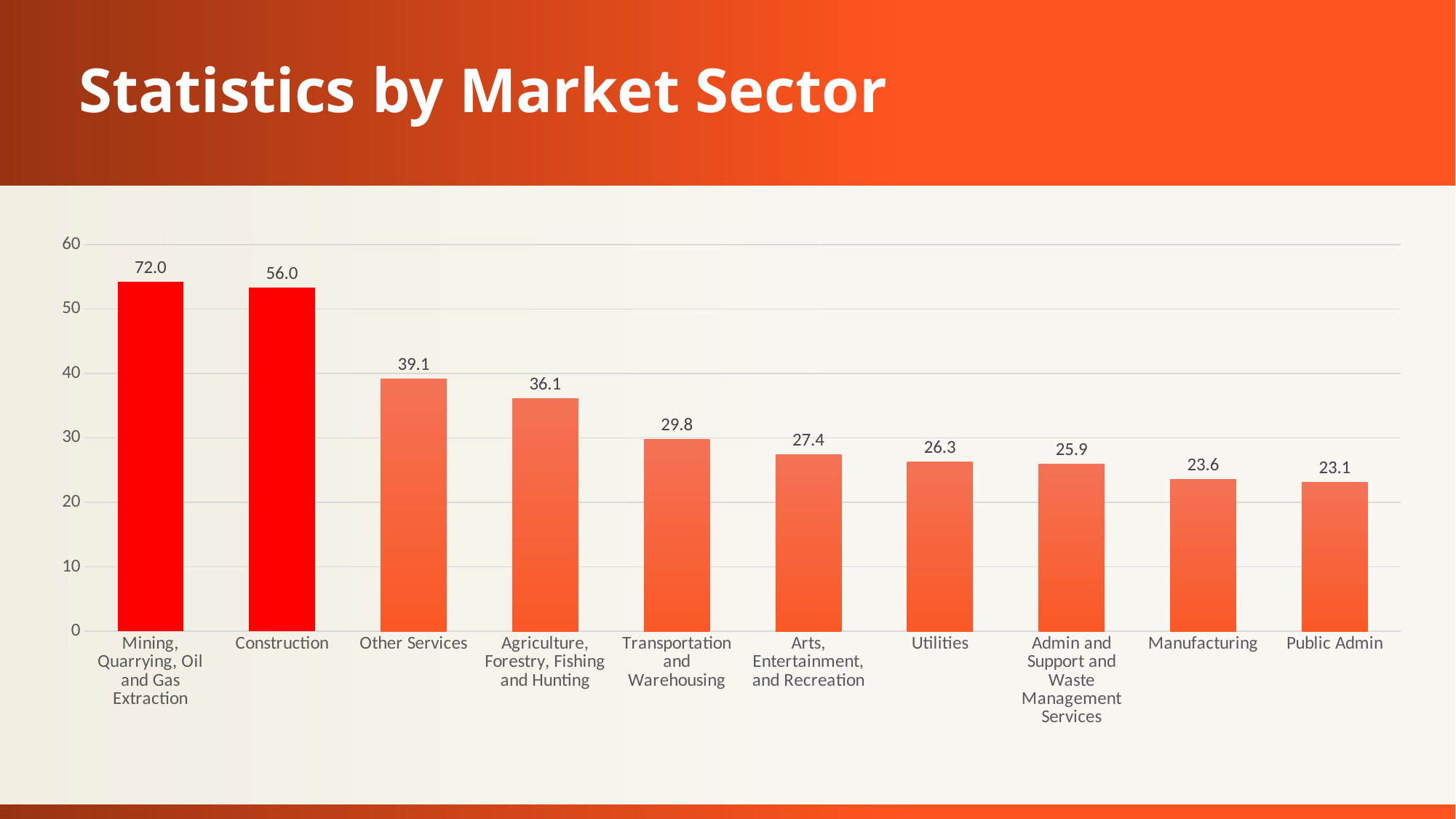
What is the value for Public Admin? 23.1 Which market sector has the highest value? Mining, Quarrying, Oil and Gas Extraction What is the value for Construction? 56.0 Which is larger, the value for Utilities or the value for Manufacturing? Utilities Which market sector has the lowest value? Public Admin Do the values rise or fall from left to right along the x axis? Fall What is the difference between the values for Construction and Other Services? 16.9 What kind of chart is shown on the slide? Bar chart How many market sectors are shown in the chart? 10 Is the value for Agriculture, Forestry, Fishing and Hunting greater or less than 30? greater What is the value for Other Services? 39.1 What is the value for Transportation and Warehousing? 29.8